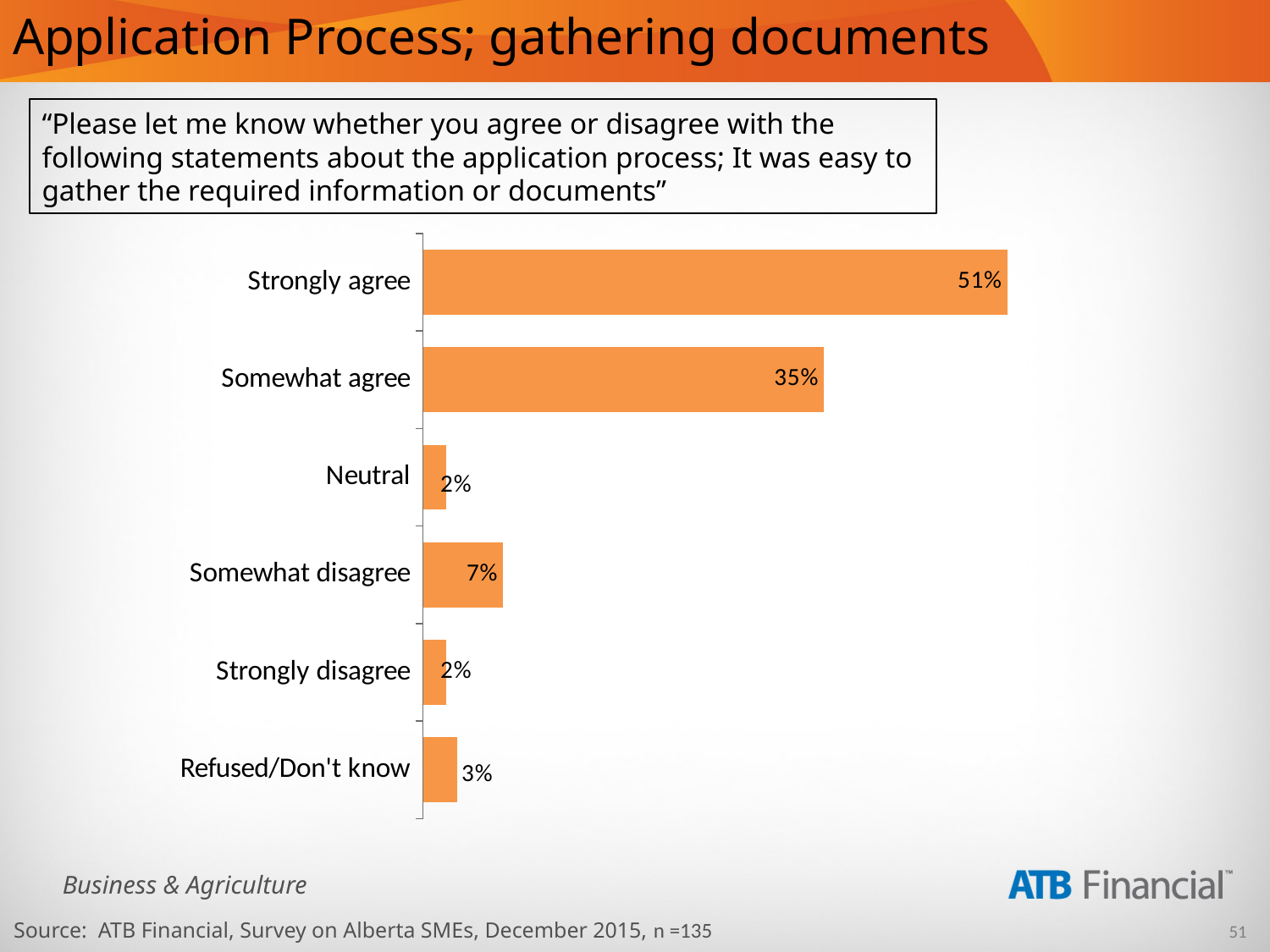
Which is larger, the value for Somewhat disagree or the value for Refused/Don't know? Somewhat disagree What colour are the bars in the chart? Orange Which category has the highest value in the chart? Strongly agree What is the value shown for Refused/Don't know? 3% What is the difference between the Strongly agree and Somewhat agree values? 16% How many categories are shown in the chart? 6 What is the value shown for Somewhat disagree? 7% What is the combined value of Strongly agree and Somewhat agree? 86% Which two categories share the same value of 2%? Neutral and Strongly disagree What percentage of respondents said they strongly agree that it was easy to gather the required information or documents? 51% What is the value shown for Somewhat agree? 35% What kind of chart is shown on the slide? Bar chart